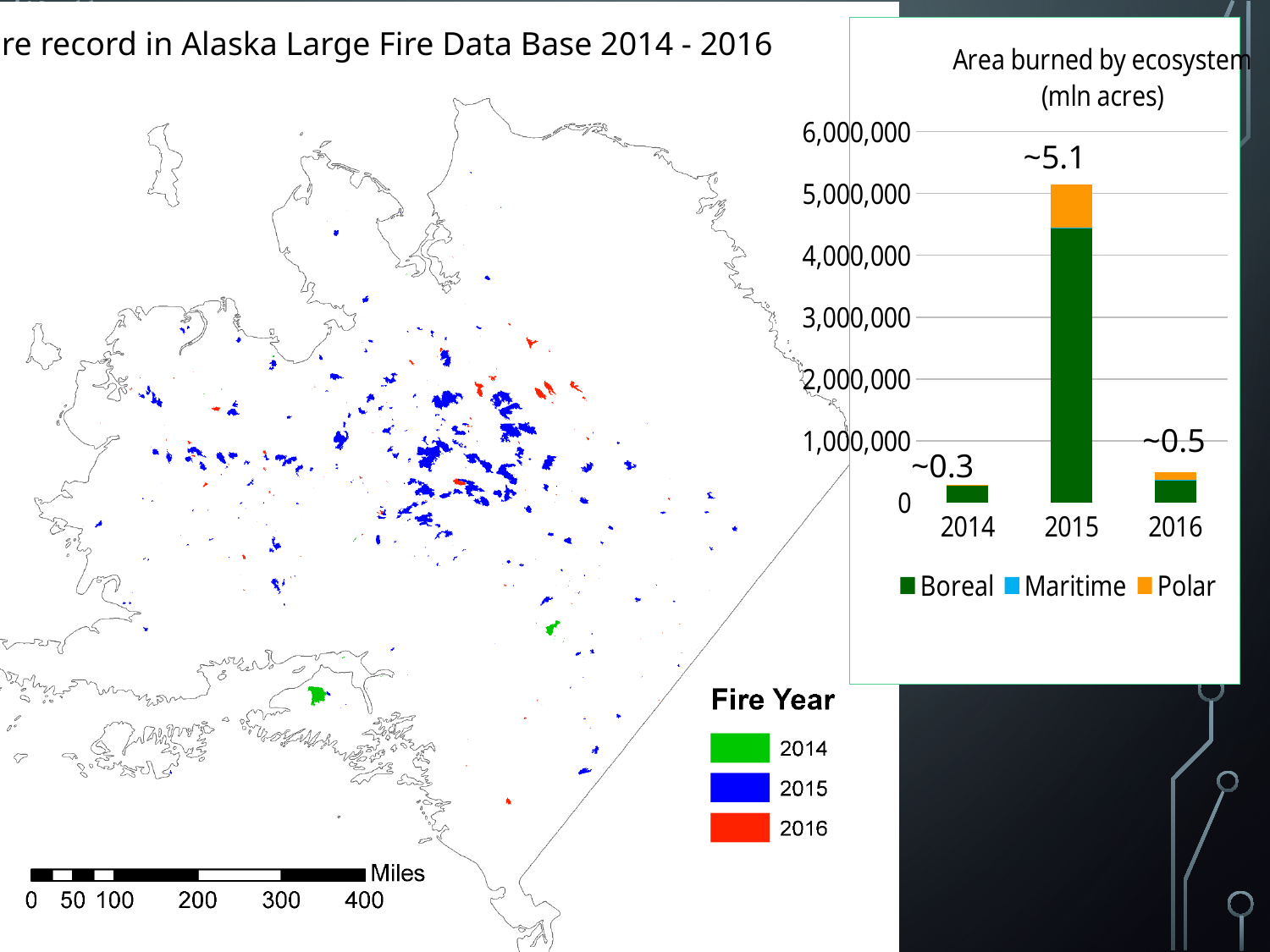
How many years are shown on the x axis of the 'Area burned by ecosystem' chart? 3 In the 'Area burned by ecosystem' chart, is the total for 2016 greater or less than 1,000,000? less In the 'Area burned by ecosystem' chart, which ecosystem makes up the largest part of the 2015 bar? Boreal In the 'Area burned by ecosystem' chart, does the total area burned rise or fall from 2015 to 2016? fall In the 'Area burned by ecosystem' chart, which year has the highest total area burned? 2015 In the 'Area burned by ecosystem' chart, is the total for 2014 greater or less than 1,000,000? less What kind of chart is 'Area burned by ecosystem (mln acres)'? stacked bar chart In the 'Area burned by ecosystem' chart, is the total for 2015 greater or less than 4,000,000? greater In the 'Area burned by ecosystem' chart, which year has the lowest total area burned? 2014 In the 'Area burned by ecosystem' chart, which year has a larger total area burned, 2015 or 2016? 2015 How many series does the legend of the 'Area burned by ecosystem' chart list? 3